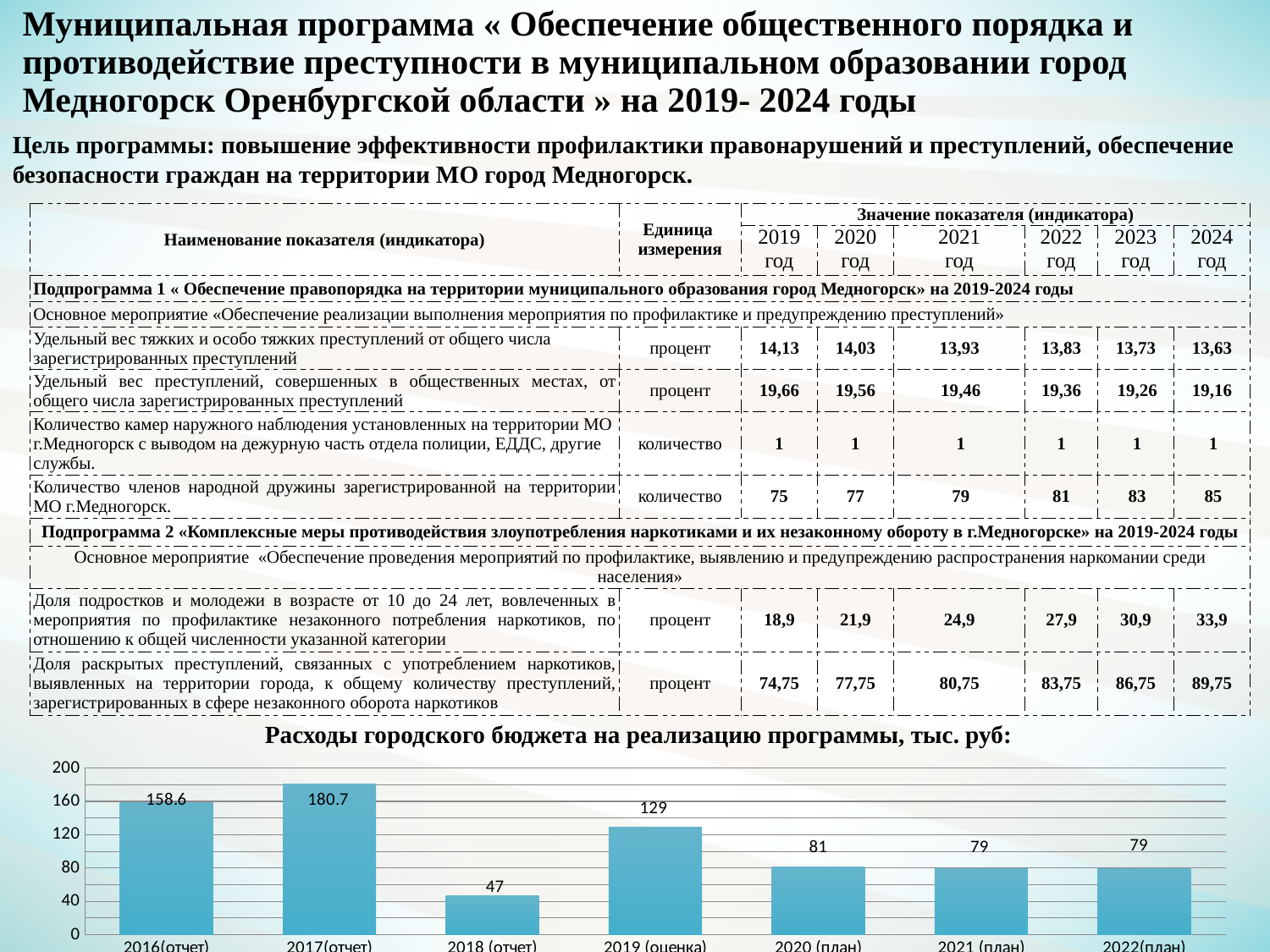
What is the value for 2017(отчет) in the chart? 180.7 Which category has the highest value in the chart? 2017(отчет) What type of chart is shown under the title "Расходы городского бюджета на реализацию программы, тыс. руб:"? bar chart What is the value for 2018 (отчет) in the chart? 47 What is the difference between the values for 2017(отчет) and 2016(отчет)? 22.1 Which category has the lowest value in the chart? 2018 (отчет) How many categories are shown on the x axis of the chart? 7 What is the value for 2019 (оценка) in the chart? 129 What is the value for 2020 (план) in the chart? 81 Is the value for 2016(отчет) greater or less than 120? greater What is the title of the chart at the bottom of the slide? Расходы городского бюджета на реализацию программы, тыс. руб: Which is larger, the value for 2019 (оценка) or the value for 2020 (план)? 2019 (оценка)